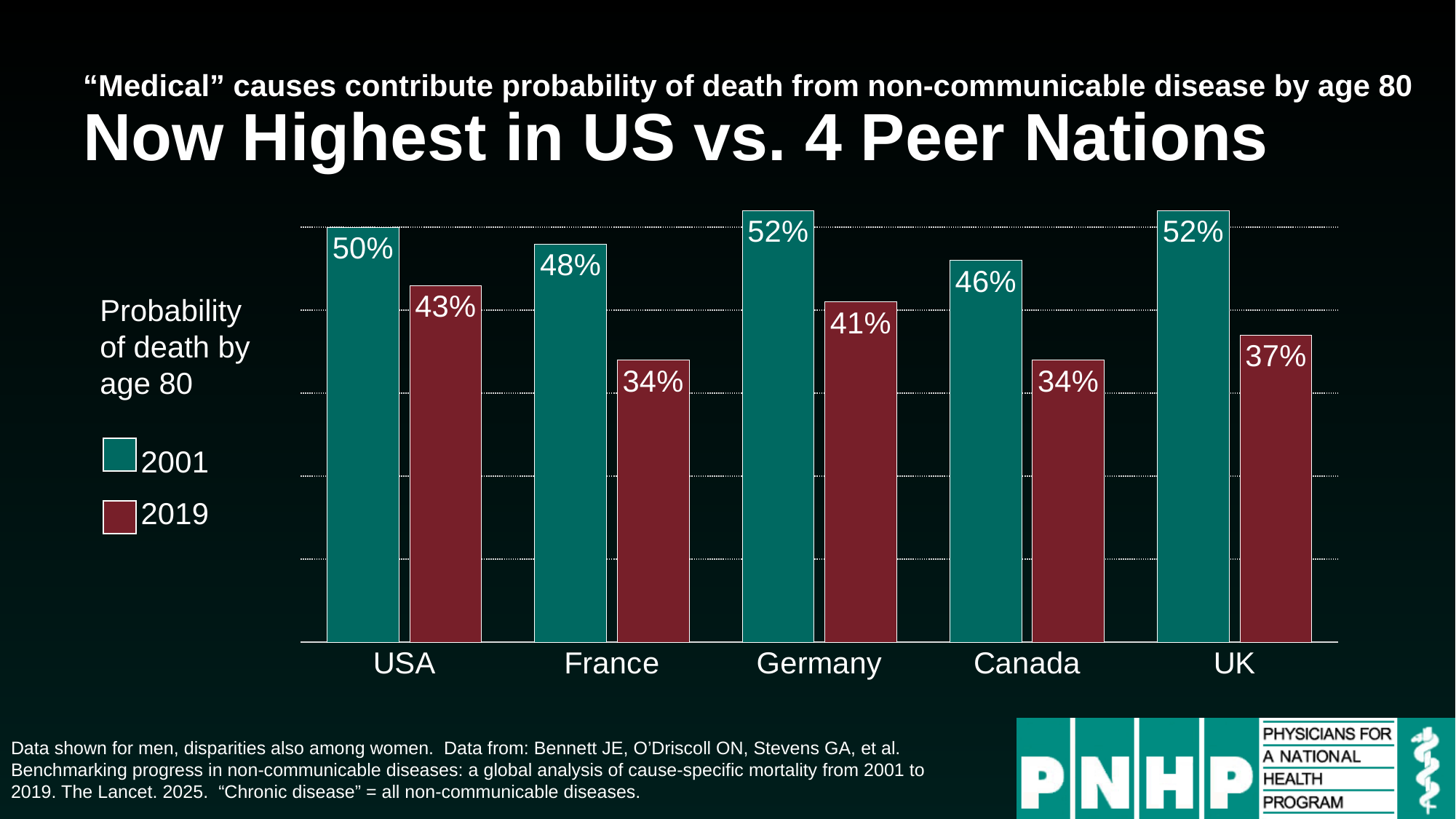
How many countries are shown on the x axis? 5 Which country has the highest 2019 value? USA Which is larger, the 2019 value for Germany or the 2019 value for the UK? Germany Which colour represents the 2019 series in the legend? Dark red Which country has the lowest 2001 value? Canada What is the 2001 value for Canada? 46% How many series does the legend list? 2 What is the 2019 value for the USA? 43% What is the difference between the 2001 and 2019 values for France? 14% What is the 2019 value for the UK? 37% What is the 2001 value for Germany? 52% What kind of chart is shown on the slide? Bar chart